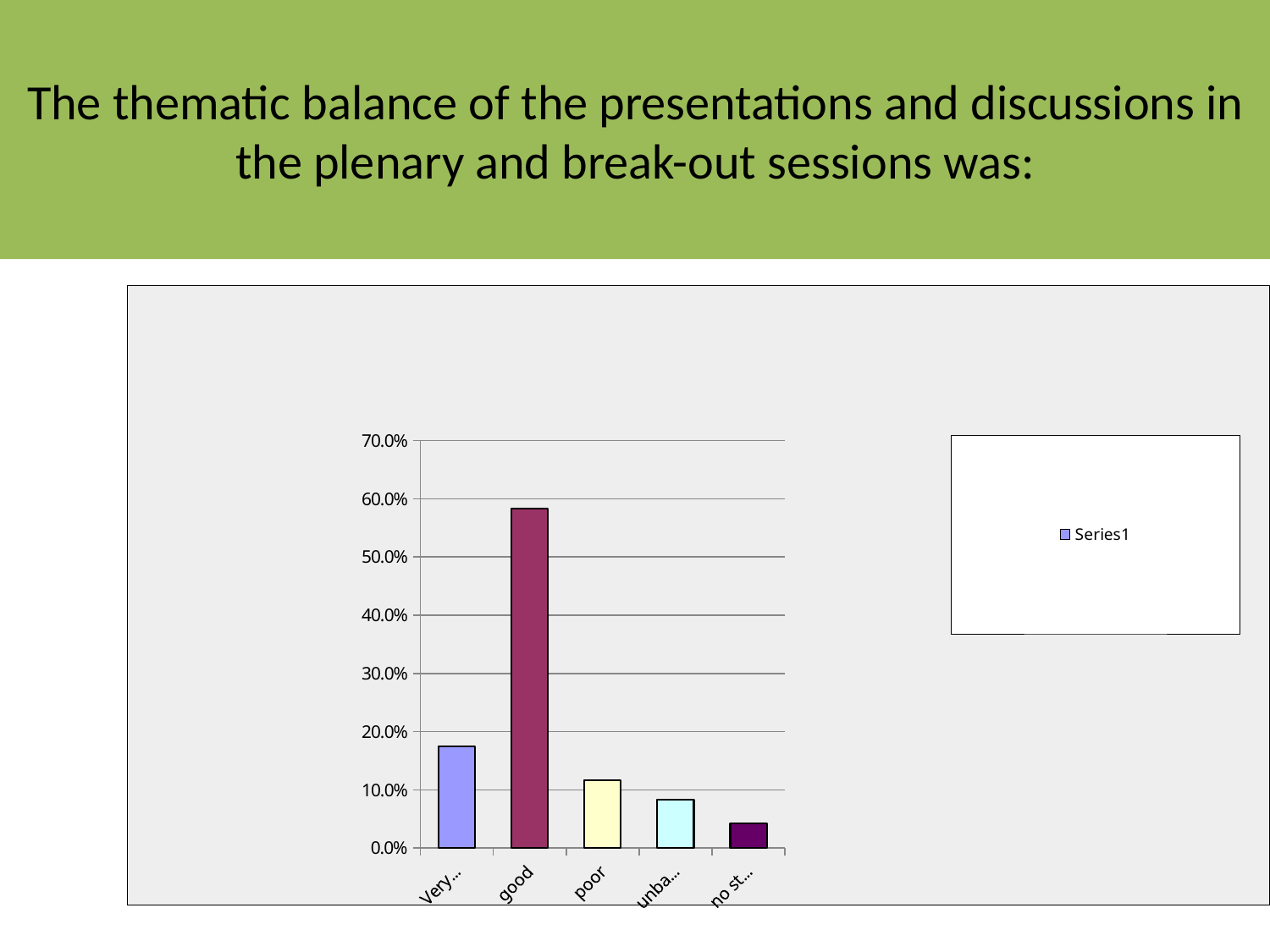
How many categories are plotted on the x axis of the chart? 5 Which is larger, the value for "good" or the value for "poor"? good Is the value for "Very…" greater or less than 20.0%? less What is the name of the series shown in the chart's legend? Series1 What kind of chart is shown on the slide? bar chart Which is larger, the value for "Very…" or the value for "poor"? Very… Which category has the highest bar in the chart? good Which category has the lowest bar in the chart? no st… Is the value for "good" greater or less than 50.0%? greater What is the highest value shown on the chart's y axis? 70.0% How many series does the chart's legend list? 1 Is the value for "unba…" greater or less than 10.0%? less